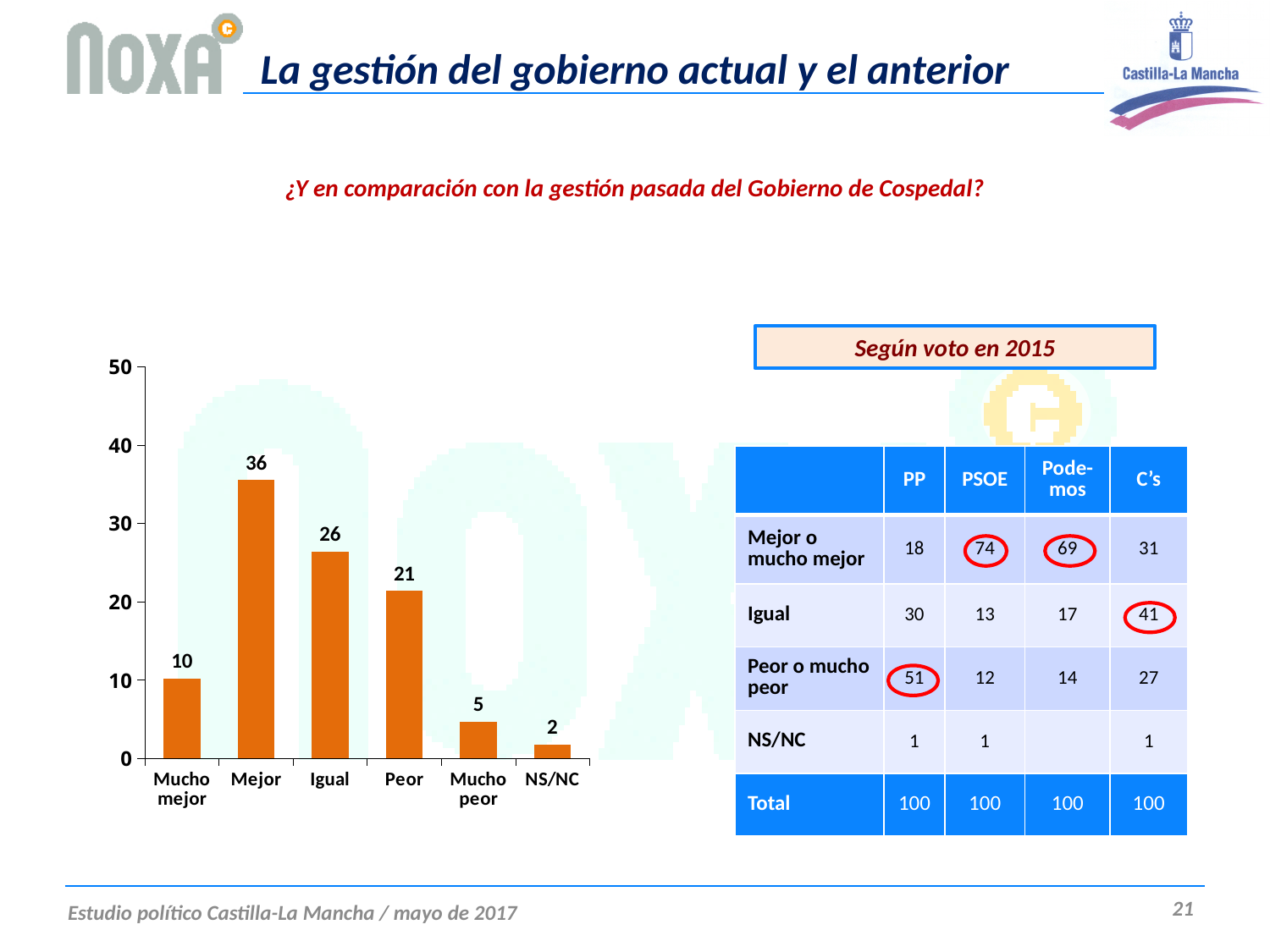
Which category has the highest value in the bar chart? Mejor What is the value for "Igual" in the bar chart? 26 What is the value for "Mejor" in the bar chart? 36 How many categories are shown on the x axis of the bar chart? 6 What is the total of the values for "Mucho mejor" and "Mejor" in the bar chart? 46 What is the highest value shown on the y axis of the bar chart? 50 What is the value for "Mucho peor" in the bar chart? 5 Which category has the lowest value in the bar chart? NS/NC Which is larger in the bar chart, the value for "Mucho mejor" or the value for "Mucho peor"? Mucho mejor What kind of chart is shown on the slide? bar chart What is the difference between the values for "Mejor" and "Peor" in the bar chart? 15 Is the value for "Igual" in the bar chart greater or less than 30? less